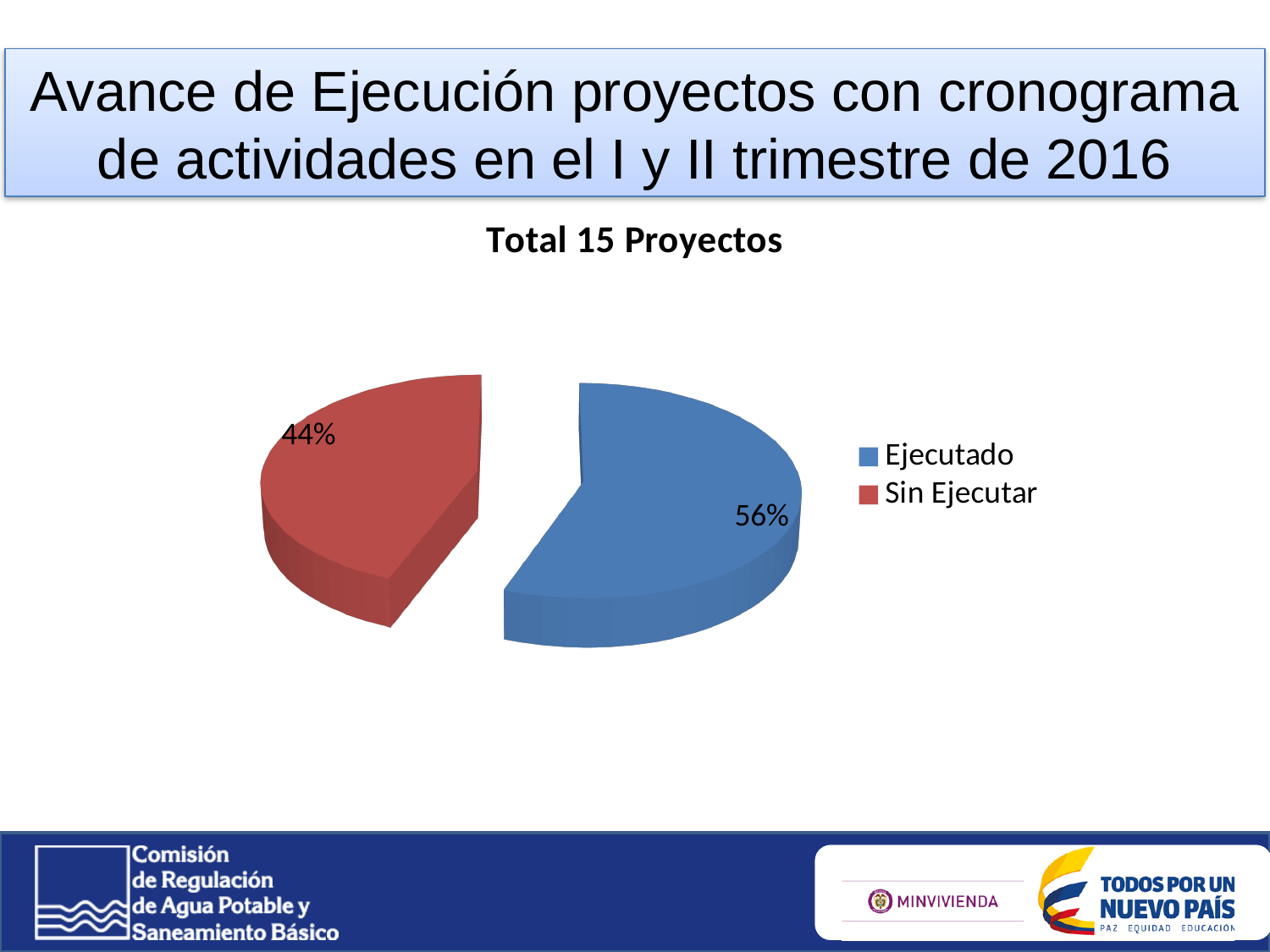
How many entries does the legend list? 2 What kind of chart is shown on the slide? pie chart What share of the pie is Ejecutado? 56% Which is larger, Ejecutado or Sin Ejecutar? Ejecutado Which slice is the smallest? Sin Ejecutar What is the chart's title? Total 15 Proyectos What is the difference between the Ejecutado and Sin Ejecutar shares? 12% What share of the pie is Sin Ejecutar? 44% Which slice is the largest? Ejecutado What colour is the Sin Ejecutar slice? red How many slices does the pie chart have? 2